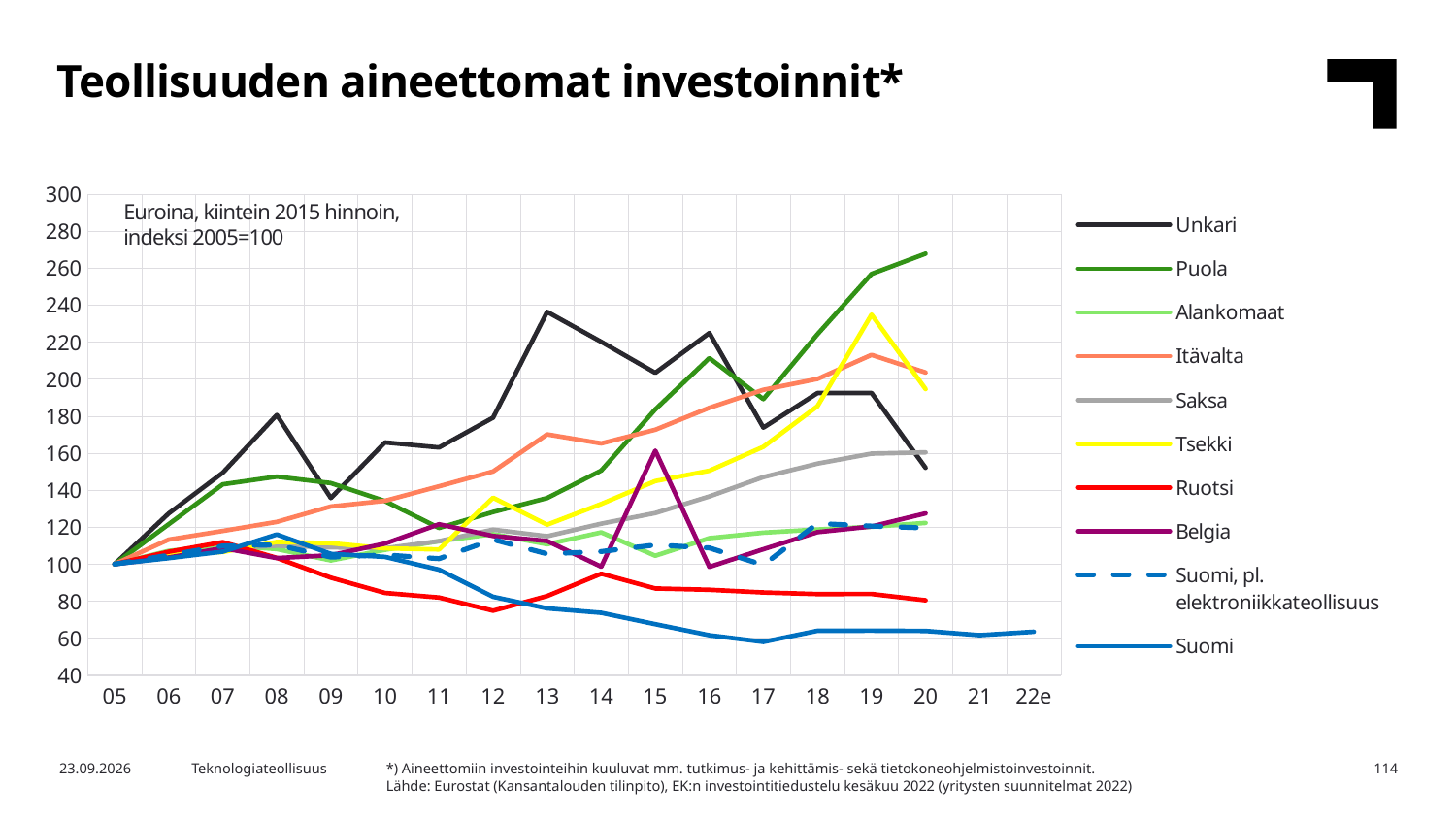
Which series is the only one that extends to 22e on the x axis? Suomi Is the value for Ruotsi in 20 greater or less than 100? less How many series does the legend list? 10 What kind of chart is shown on the slide? line chart Is the value for Puola in 20 greater or less than 260? greater How many year labels are shown on the x axis? 18 Which series has the highest value in 20? Puola Is the value for Tsekki in 19 greater or less than 220? greater Which series has the lowest value in 20? Suomi Which series has the highest value in 13? Unkari Which is larger in 20, the value for Puola or the value for Unkari? Puola Does the Ruotsi series generally rise or fall from 05 to 20? fall